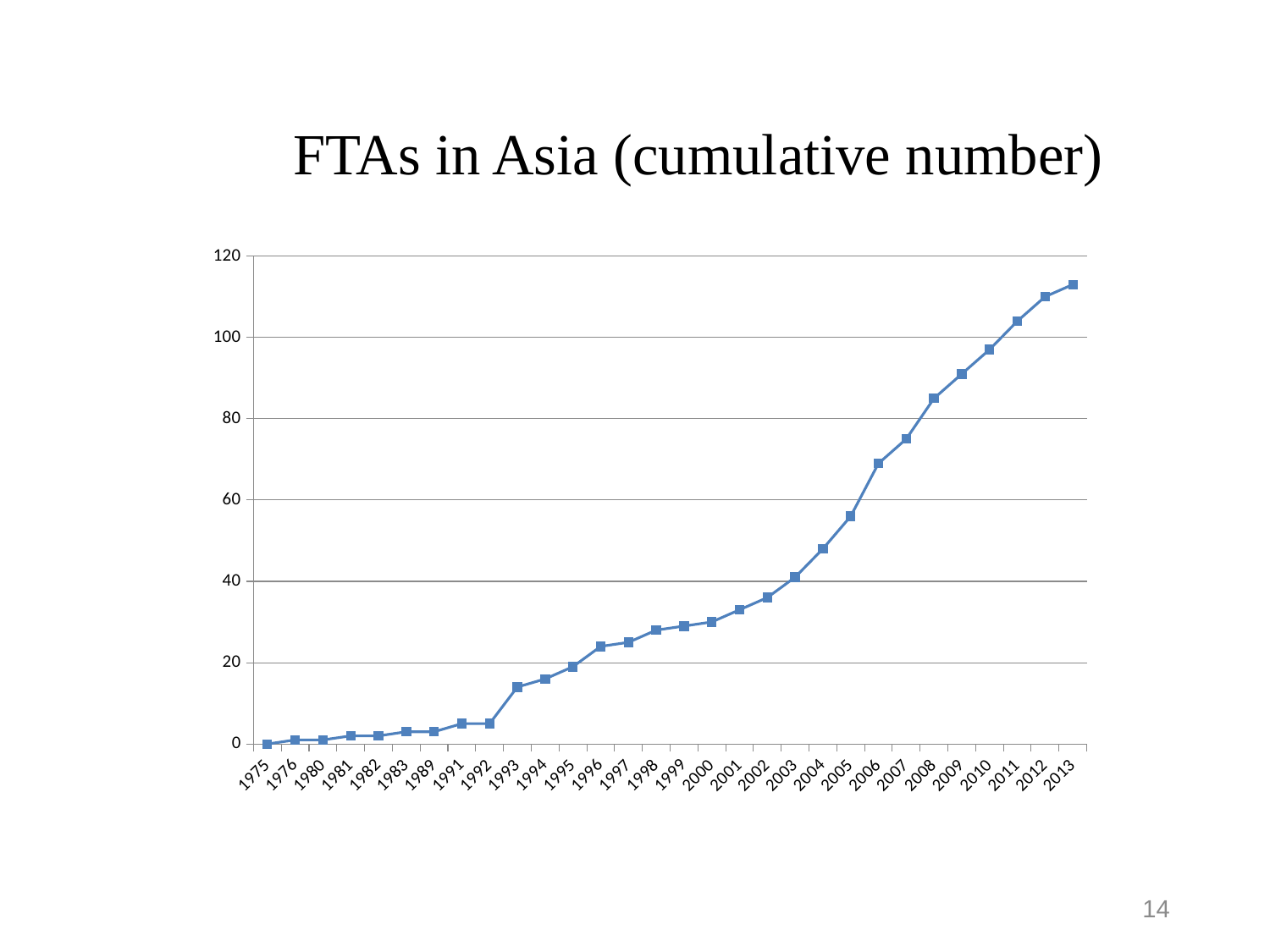
Which year has the lowest cumulative number of FTAs? 1975 Is the value for 1993 greater or less than 20? less Do the values rise or fall from 1975 to 2013? rise Is the value for 2008 greater or less than 80? greater Which is larger, the value for 2006 or the value for 1996? 2006 How many years are plotted along the x axis? 30 What is the cumulative number of FTAs in 1975? 0 Which year has the highest cumulative number of FTAs? 2013 What kind of chart is shown on the slide? line chart What is the title of the chart? FTAs in Asia (cumulative number) Is the value for 2013 greater or less than 100? greater